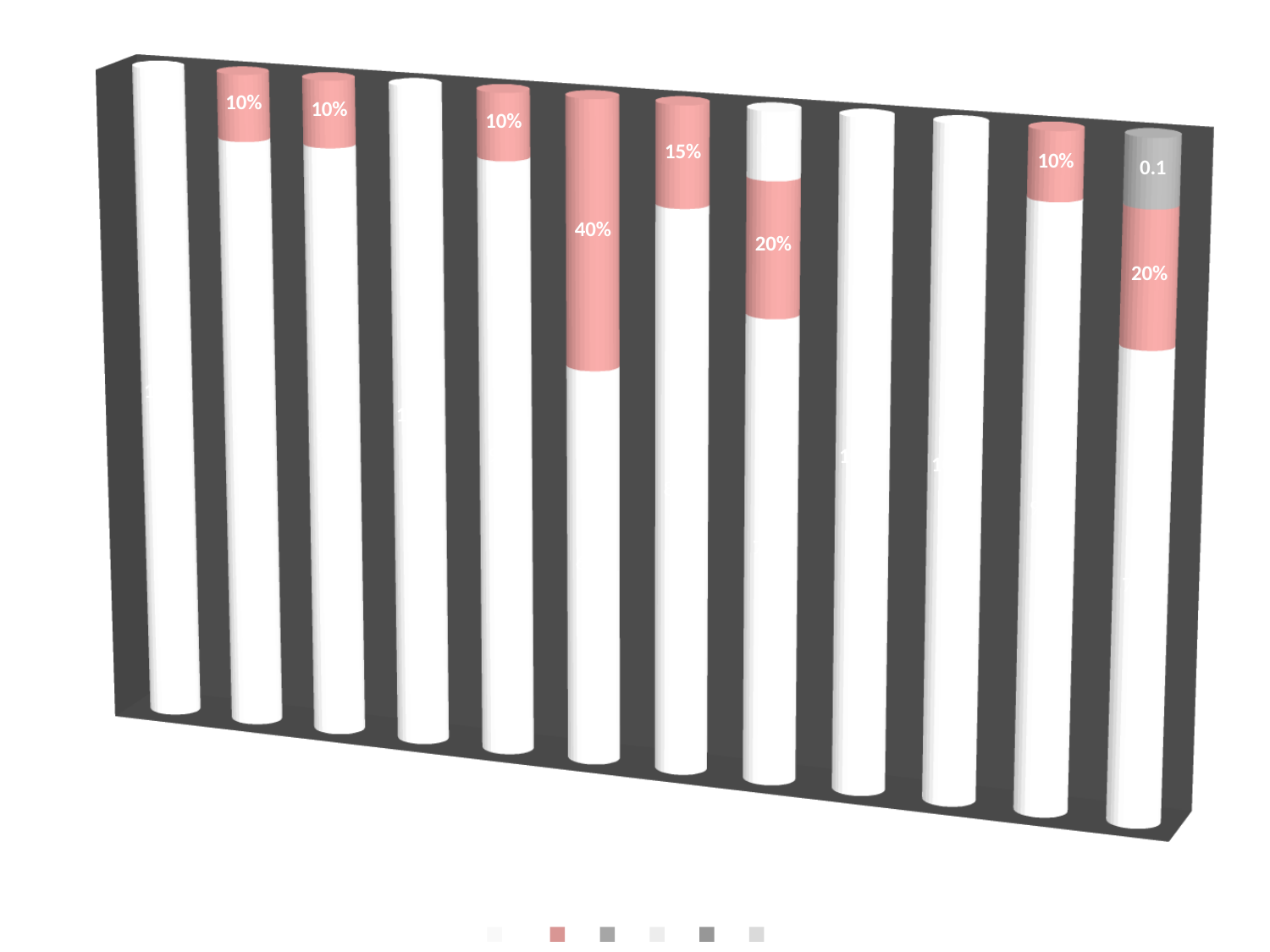
Which bar has the largest pink segment? the sixth bar from the left (40%) What is the value printed on the pink segment of the seventh bar from the left? 15% How many series does the legend list? 6 Which is larger: the pink segment of the sixth bar from the left or the pink segment of the eighth bar from the left? the sixth bar (40%) What is the value printed on the pink segment of the sixth bar from the left? 40% How many bars have a pink segment with a printed label? 8 What is the value printed on the pink segment of the eighth bar from the left? 20% What is the difference between the pink segment of the sixth bar (40%) and the pink segment of the seventh bar (15%)? 25% How many bars are plotted in the chart? 12 What kind of chart is shown on the slide? bar chart What is the value printed on the pink segment of the rightmost bar? 20% What value is printed on the grey segment at the top of the rightmost bar? 0.1